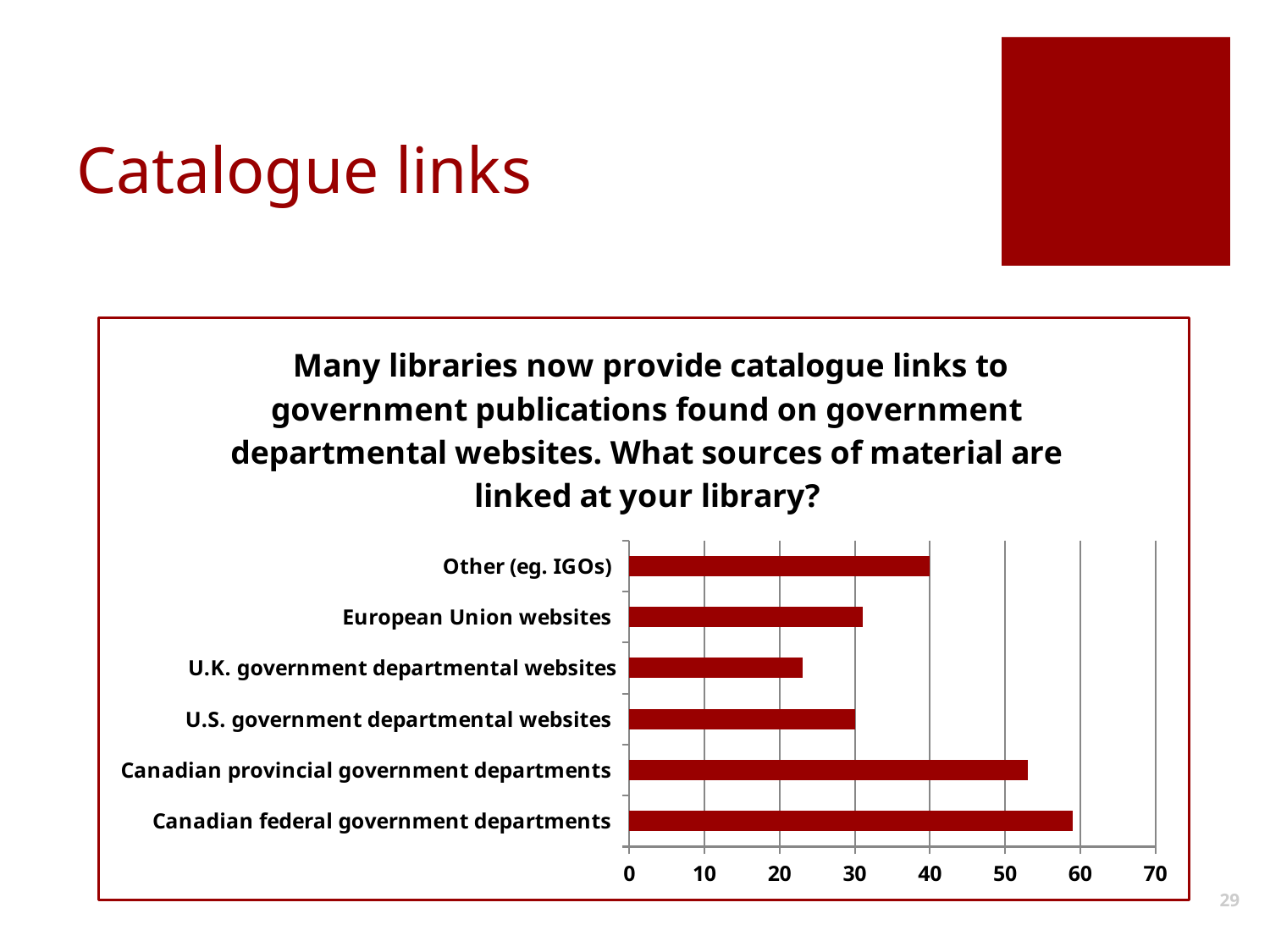
Is the value for European Union websites greater or less than 40? less Which is larger: the value for Other (eg. IGOs) or the value for U.K. government departmental websites? Other (eg. IGOs) Is the value for Other (eg. IGOs) greater or less than 50? less Which source of material has the highest value in the chart? Canadian federal government departments Is the value for U.K. government departmental websites greater or less than 30? less What is the highest value shown on the chart's horizontal axis? 70 Which is larger: the value for Canadian provincial government departments or the value for Other (eg. IGOs)? Canadian provincial government departments How many categories (sources of material) are plotted in the chart? 6 Which source of material has the lowest value in the chart? U.K. government departmental websites What kind of chart is shown on the slide? bar chart